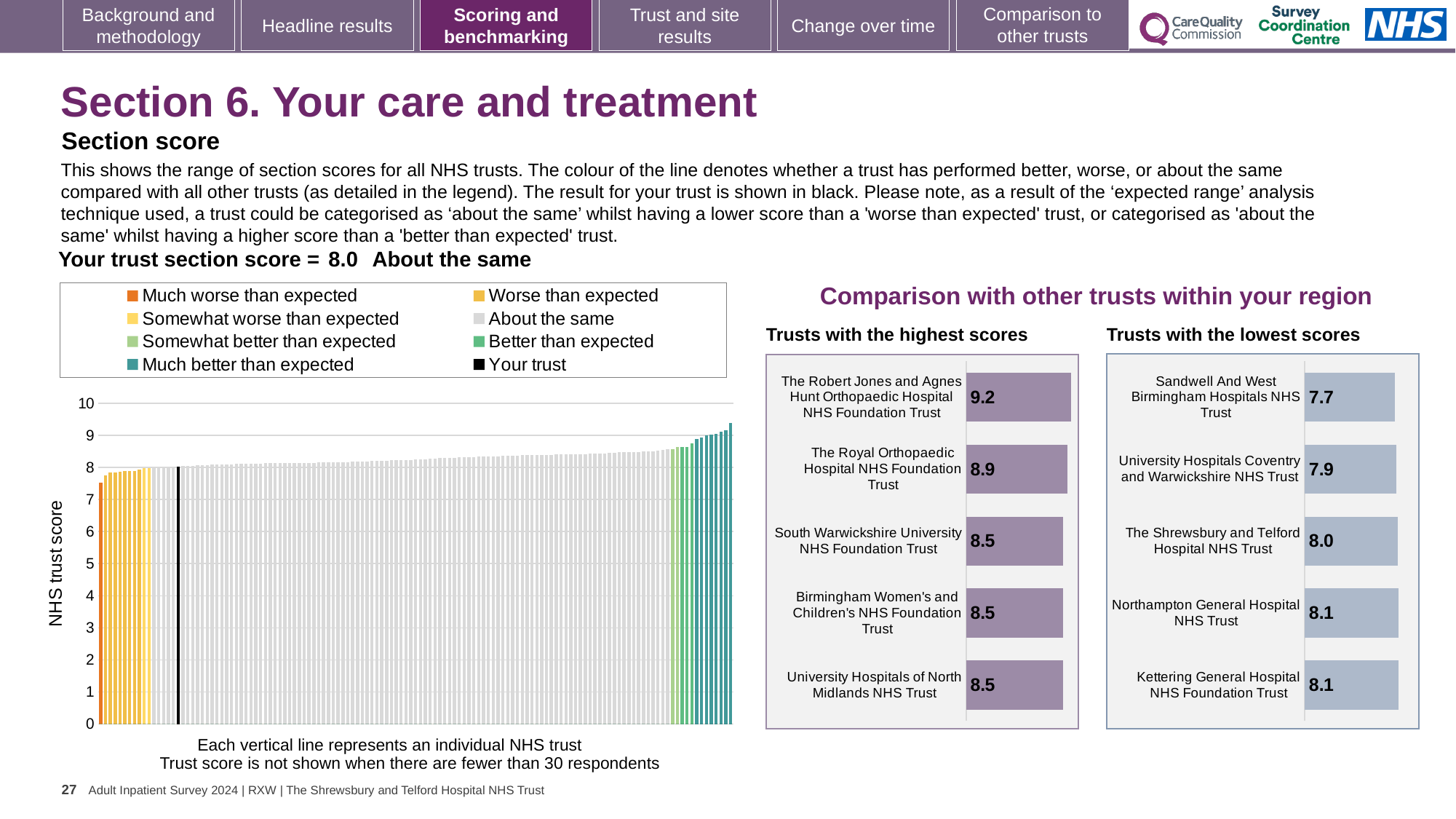
In the 'Trusts with the lowest scores' chart, what is the difference between the scores of Kettering General Hospital NHS Foundation Trust and Sandwell And West Birmingham Hospitals NHS Trust? 0.4 In the 'Trusts with the highest scores' chart, what is the difference between the scores of The Robert Jones and Agnes Hunt Orthopaedic Hospital NHS Foundation Trust and The Royal Orthopaedic Hospital NHS Foundation Trust? 0.3 In the 'Trusts with the lowest scores' chart, which trust has the lowest score? Sandwell And West Birmingham Hospitals NHS Trust In the 'Trusts with the lowest scores' chart, what is the score for Sandwell And West Birmingham Hospitals NHS Trust? 7.7 How many entries does the legend of the large 'NHS trust score' chart list? 8 What is the title above the two small bar charts on the right of the slide? Comparison with other trusts within your region In the 'Trusts with the highest scores' chart, what is the score for The Robert Jones and Agnes Hunt Orthopaedic Hospital NHS Foundation Trust? 9.2 In the large 'NHS trust score' chart, is the value for the black 'Your trust' bar greater or less than 5? greater How many trusts are shown in the 'Trusts with the highest scores' chart? 5 In the 'Trusts with the highest scores' chart, which trust has the highest score? The Robert Jones and Agnes Hunt Orthopaedic Hospital NHS Foundation Trust What kind of chart is the large 'NHS trust score' chart on the left of the slide? Bar chart Which has the higher score: The Royal Orthopaedic Hospital NHS Foundation Trust in the highest-scores chart or University Hospitals Coventry and Warwickshire NHS Trust in the lowest-scores chart? The Royal Orthopaedic Hospital NHS Foundation Trust